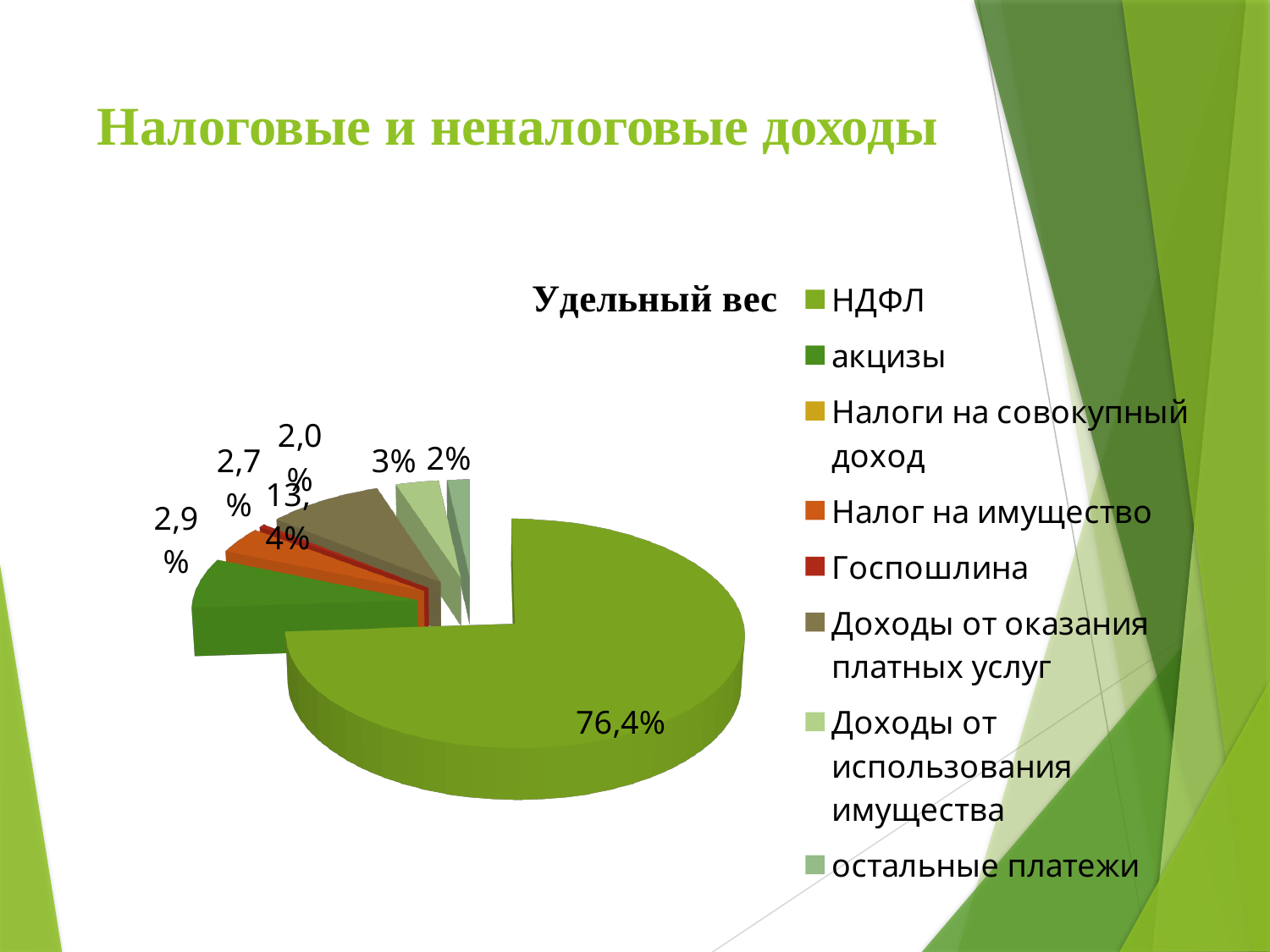
Which category is listed first in the legend? НДФЛ Which category has the largest slice of the pie? НДФЛ Which category is listed last in the legend? остальные платежи Which is larger, the slice for НДФЛ or the slice for акцизы? НДФЛ What is the title of the chart? Удельный вес What kind of chart is shown on the slide? pie chart How many categories does the chart's legend list? 8 What share of the pie does НДФЛ have? 76,4%